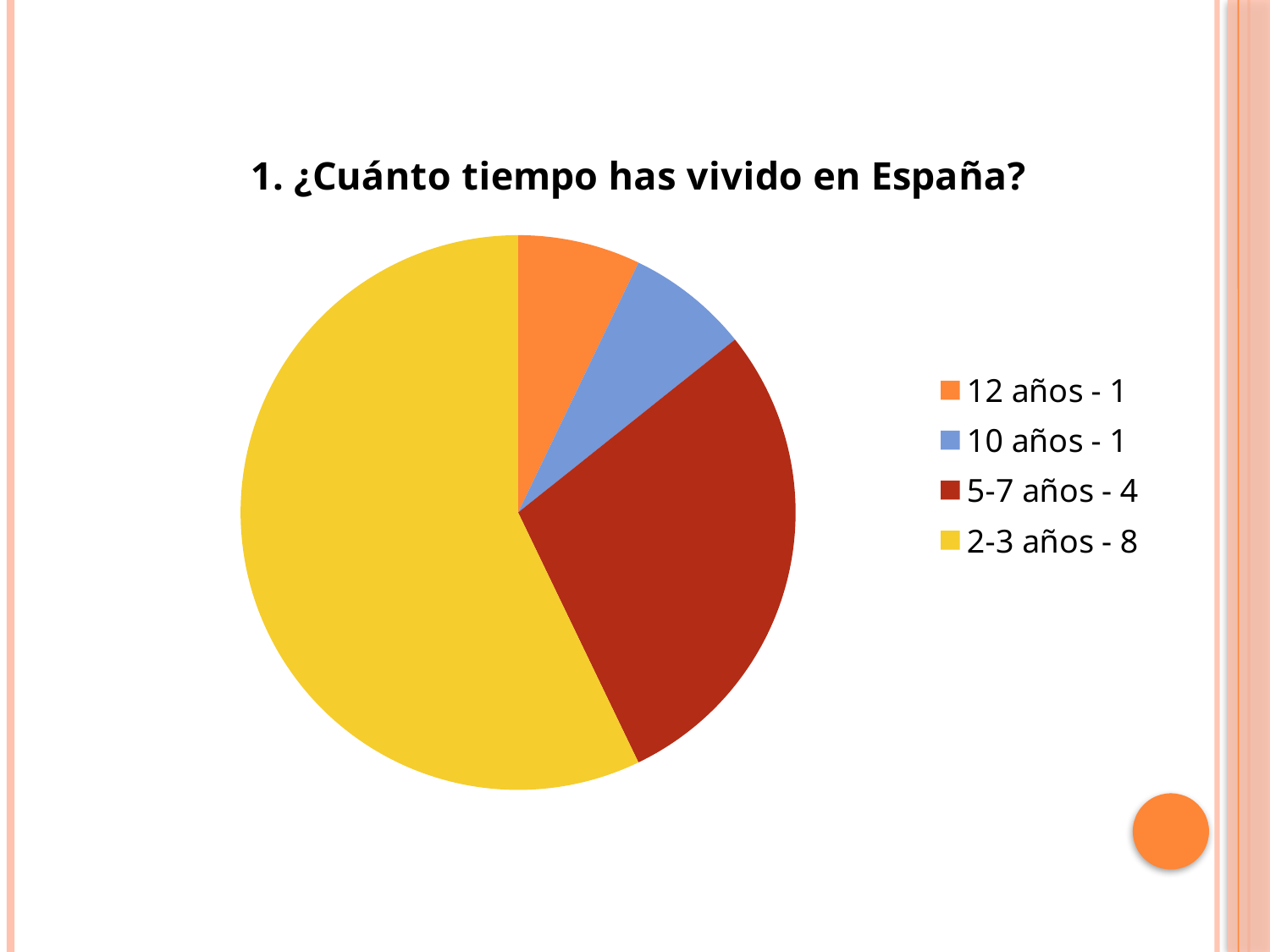
What is the value for the category '2-3 años'? 8 How many categories does the pie chart have? 4 What is the difference between the values for '2-3 años' and '5-7 años'? 4 What type of chart is shown on the slide? pie chart What is the title of the chart? 1. ¿Cuánto tiempo has vivido en España? What is the value for the category '12 años'? 1 What is the value for the category '5-7 años'? 4 Which is larger, the value for '5-7 años' or the value for '10 años'? 5-7 años What share of the total does the '2-3 años' slice represent? 8 out of 14 What colour is the slice for '5-7 años'? dark red What is the total of all the values in the pie chart? 14 Which category has the largest slice of the pie? 2-3 años